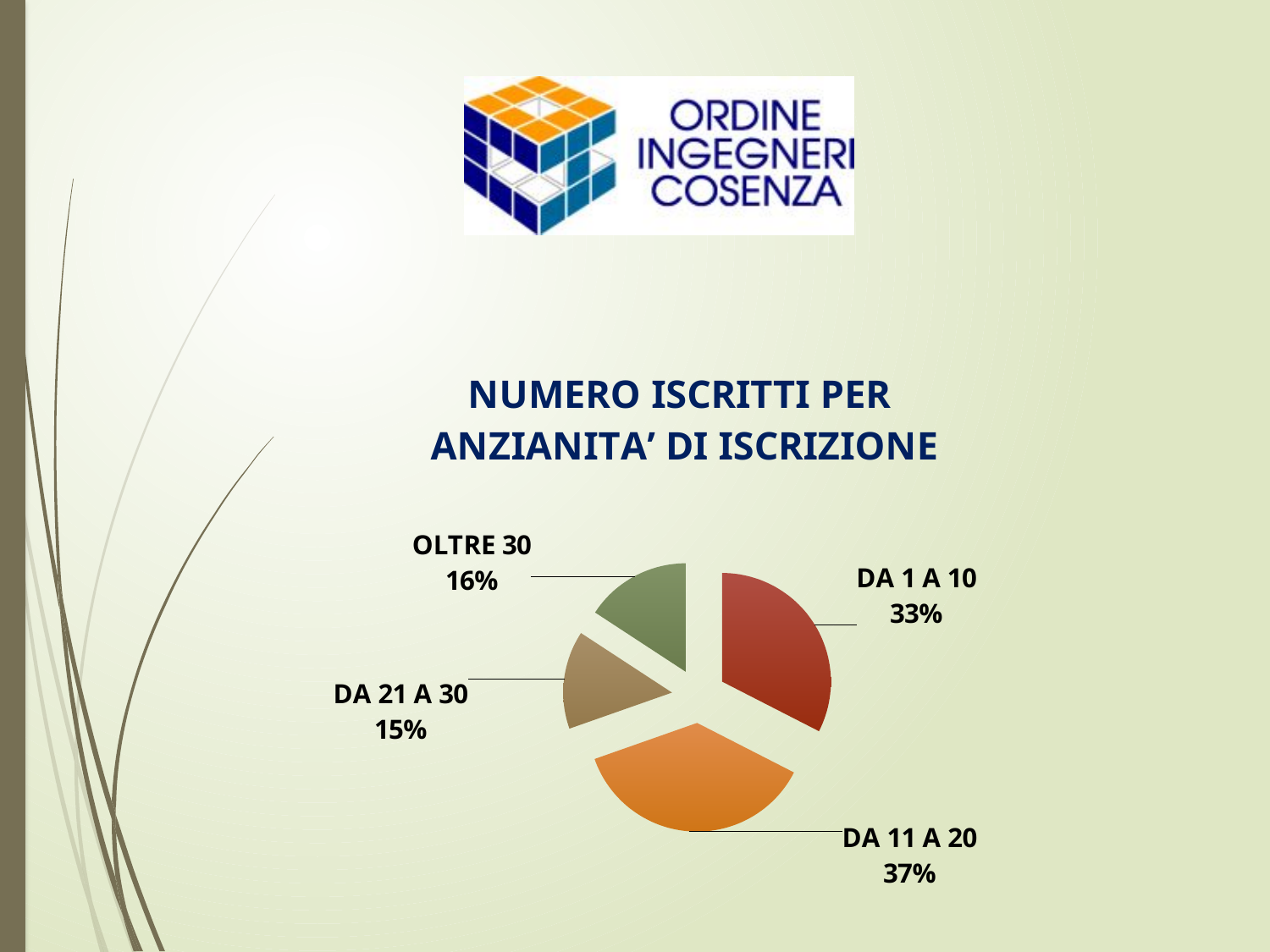
What is the title of the chart? NUMERO ISCRITTI PER ANZIANITA' DI ISCRIZIONE How many slices does the pie chart have? 4 What share of the pie does DA 11 A 20 represent? 37% What is the combined share of DA 21 A 30 and OLTRE 30? 31% What is the difference in percentage points between DA 11 A 20 and DA 1 A 10? 4 What share of the pie does OLTRE 30 represent? 16% What share of the pie does DA 21 A 30 represent? 15% What share of the pie does DA 1 A 10 represent? 33% Which is larger, the share for DA 1 A 10 or the share for OLTRE 30? DA 1 A 10 Which category has the smallest share of the pie? DA 21 A 30 Which category has the largest share of the pie? DA 11 A 20 What kind of chart is shown on the slide? pie chart